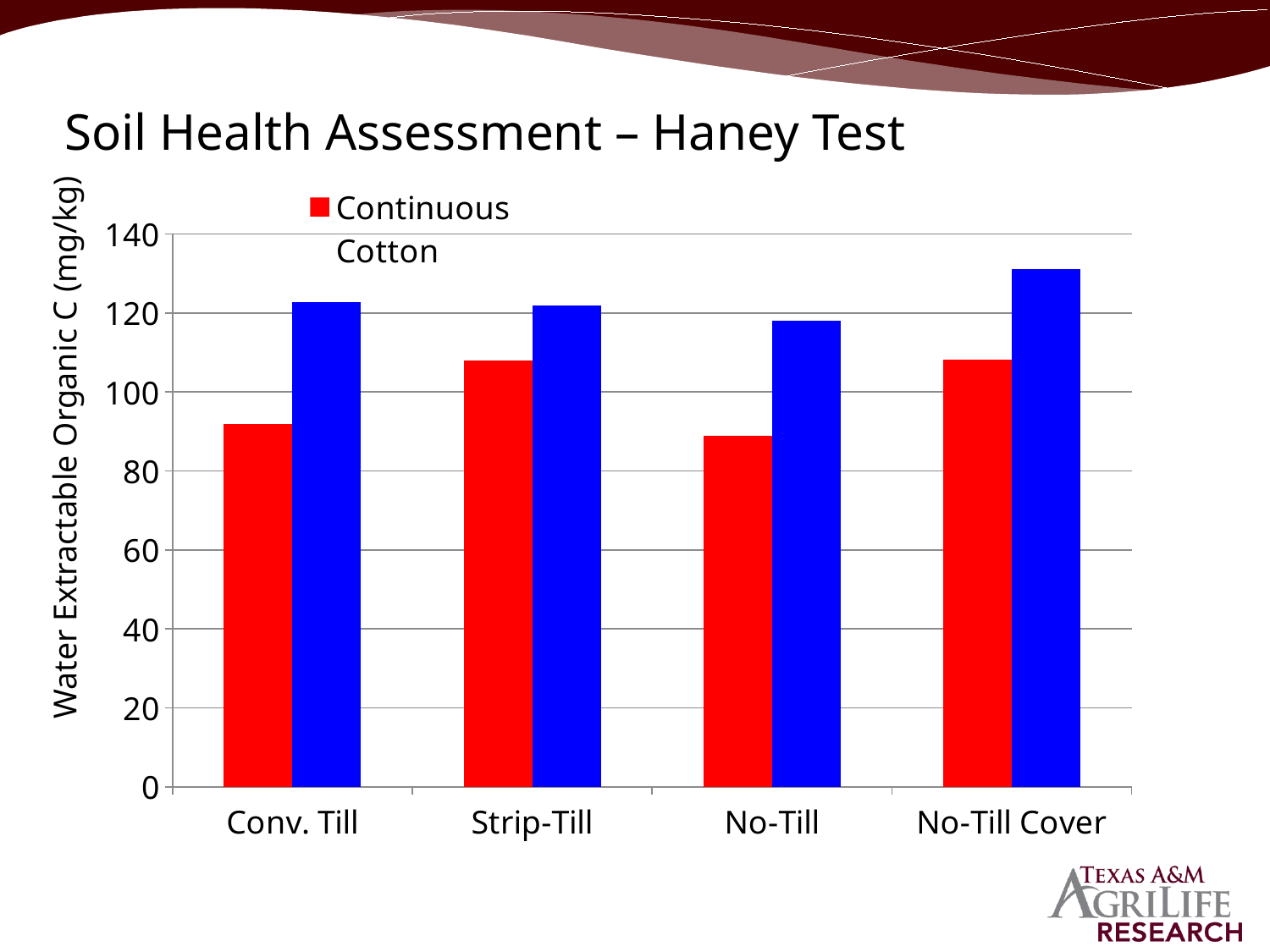
How many tillage categories are shown on the x axis? 4 How many bars are plotted for each tillage category? 2 Which is larger for Continuous Cotton: Conv. Till or Strip-Till? Strip-Till Is the Continuous Cotton value for No-Till greater or less than 100? less Is the blue bar for No-Till Cover greater or less than 120? greater Is the Continuous Cotton value for Strip-Till greater or less than 100? greater What kind of chart is shown on the slide? bar chart Which category has the tallest blue bar? No-Till Cover What is the title of the slide's chart? Soil Health Assessment – Haney Test What is the label of the vertical axis? Water Extractable Organic C (mg/kg) For Conv. Till, which is larger: the Continuous Cotton bar or the blue bar? the blue bar